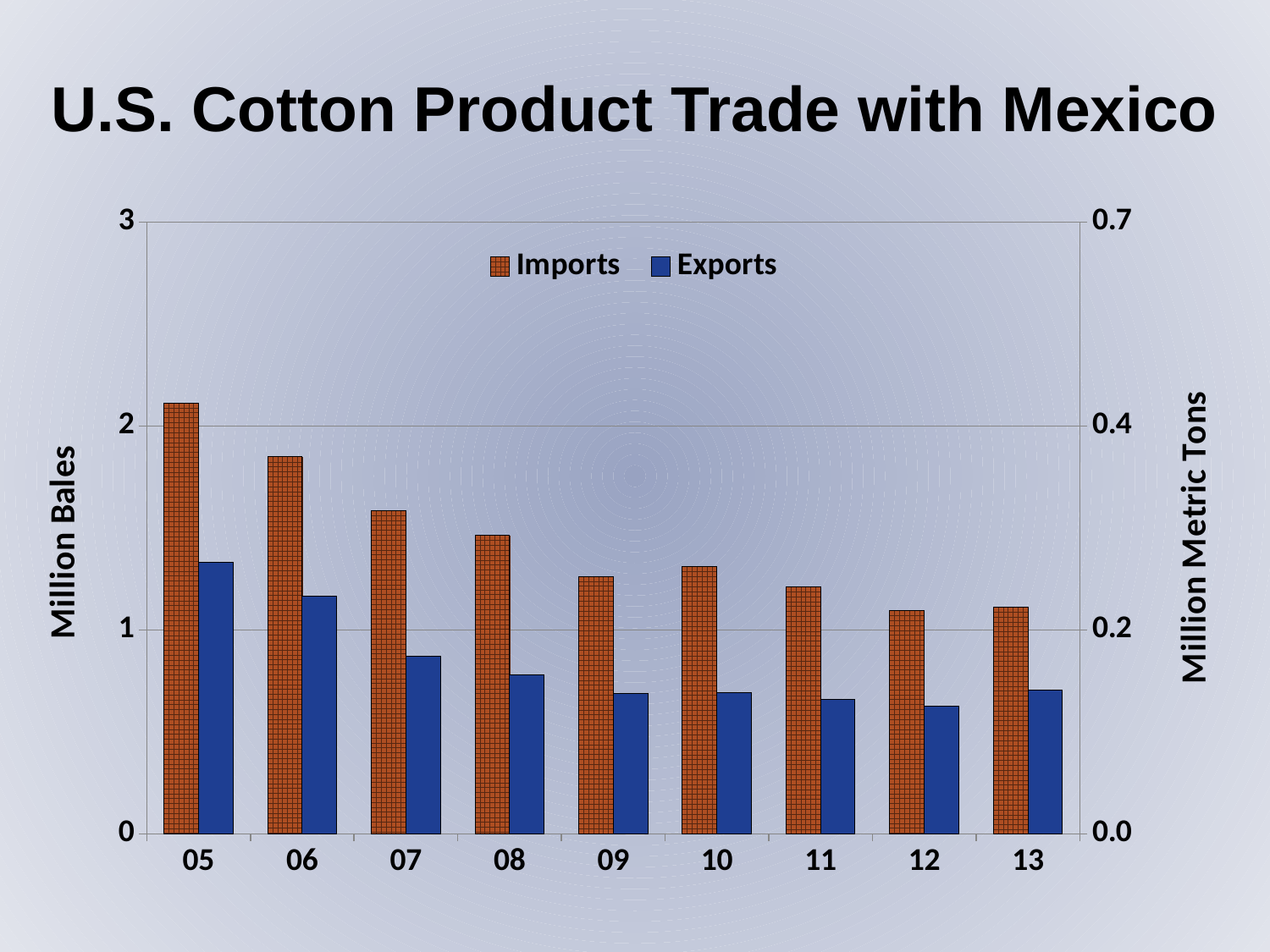
What kind of chart is shown on the slide? Bar chart Is the Exports value for 05 greater or less than 1? greater Which is larger, Imports in 05 or Imports in 13? Imports in 05 Is the Exports value for 07 greater or less than 1? less Is the Imports value for 06 greater or less than 2? less How many series does the legend list? 2 How many years are shown on the x axis? 9 In which year are Imports highest? 05 What is the title of the chart? U.S. Cotton Product Trade with Mexico Do Imports generally rise or fall from 05 to 13? Fall In which year are Exports highest? 05